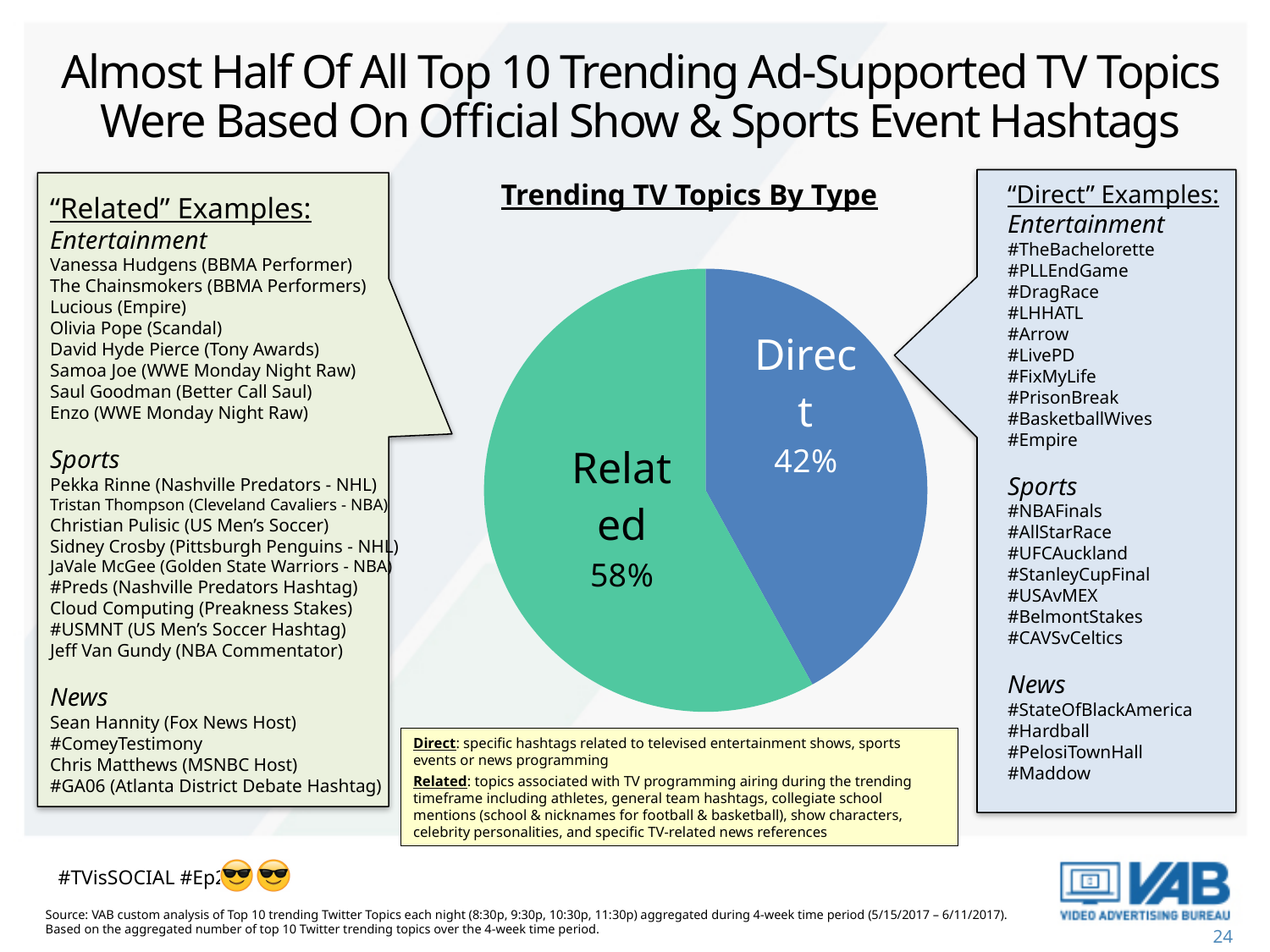
What do the two slices of the pie chart add up to? 100% Is the share for Direct greater or less than 50%? less Which is larger, the Related slice or the Direct slice? Related What share of trending TV topics is labelled "Related"? 58% How many slices does the pie chart have? 2 What is the difference in percentage points between the Related and Direct slices? 16 Which slice of the pie is the smallest? Direct What colour is the Related slice of the pie chart? green What is the title of the pie chart? Trending TV Topics By Type What type of chart is shown under the title "Trending TV Topics By Type"? pie chart Which slice of the pie is the largest? Related What share of trending TV topics is labelled "Direct"? 42%